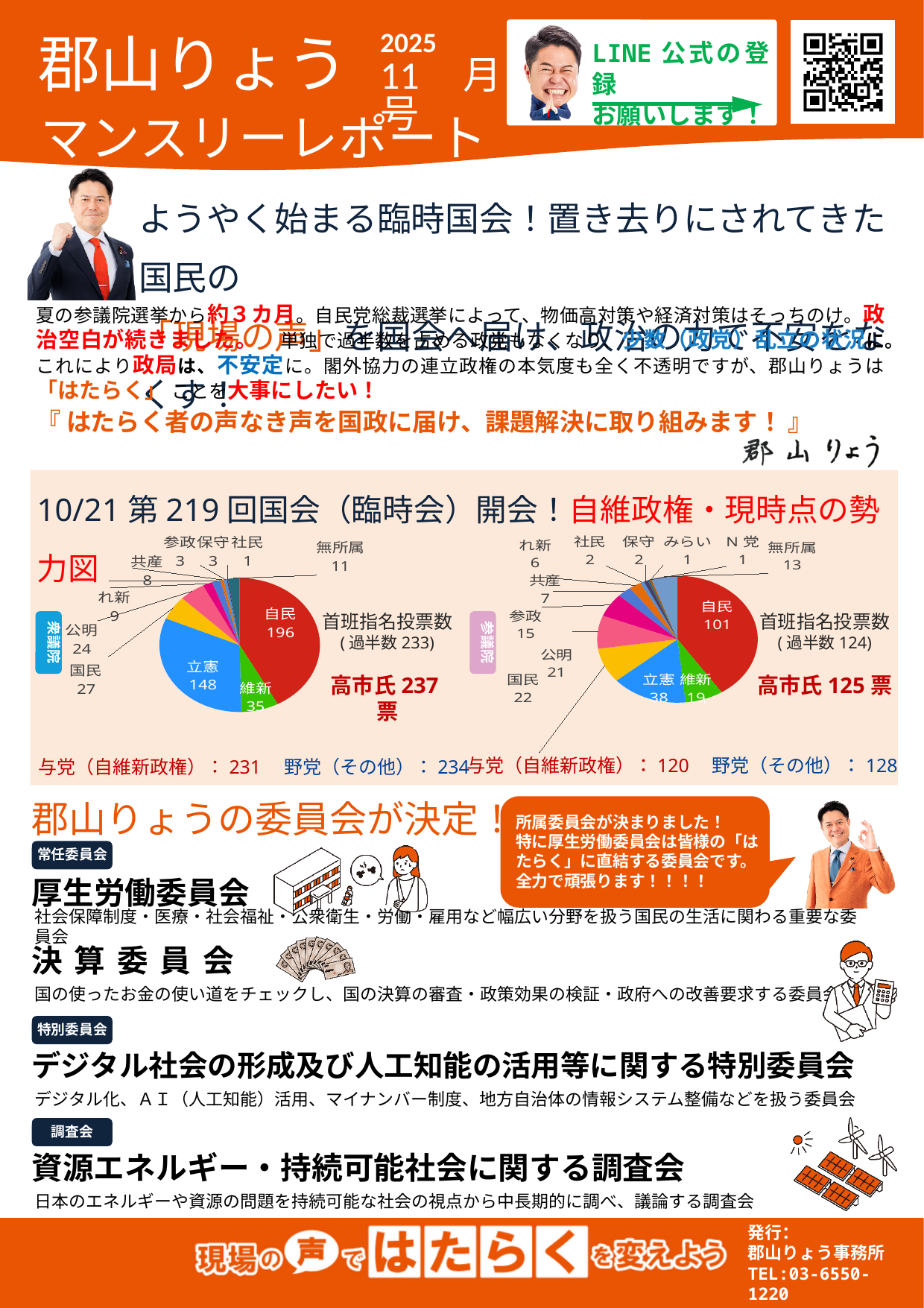
In the 衆議院 (left) pie chart, what is the difference between 自民 and 立憲? 48 In the 衆議院 (left) pie chart, which is larger, 国民 or 公明? 国民 In the 衆議院 (left) pie chart, what is the value for 自民? 196 In the 衆議院 (left) pie chart, which party has the largest slice? 自民 What type of chart is used to show the 衆議院 首班指名投票数? Pie chart In the 参議院 (right) pie chart, what is the difference between 国民 and 維新? 3 How many slices does the 参議院 (right) pie chart have? 13 In the 衆議院 (left) pie chart, which party has the smallest slice? 社民 In the 参議院 (right) pie chart, which party has the largest slice? 自民 In the 参議院 (right) pie chart, what is the value for 公明? 21 In the 衆議院 (left) pie chart, what is the value for 無所属? 11 In the 参議院 (right) pie chart, what is the value for 立憲? 38